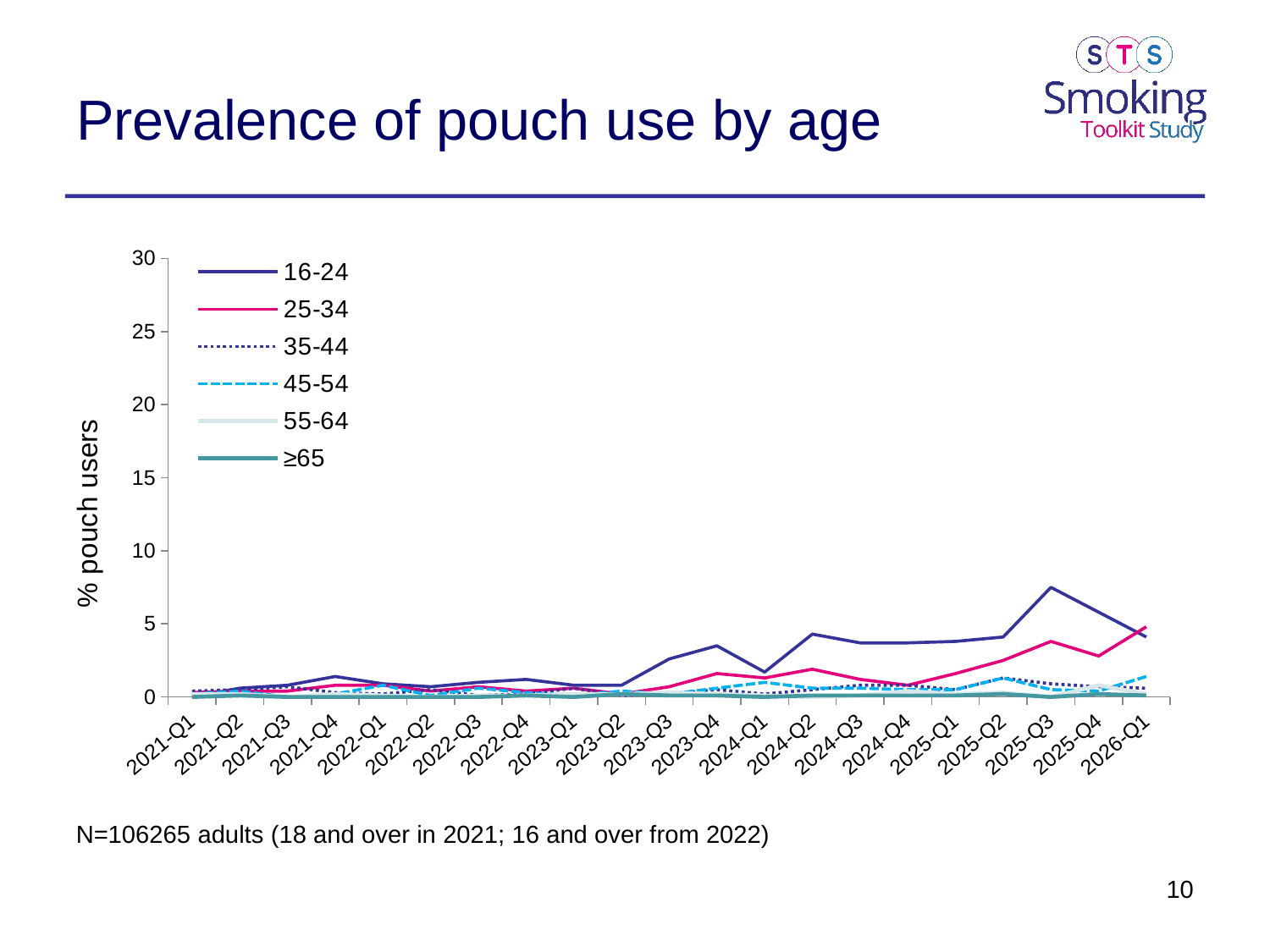
Is the value for the 16-24 series at 2025-Q3 greater or less than 10? less Is the value for the ≥65 series at 2026-Q1 greater or less than 5? less What is the label on the y axis? % pouch users Is the value for the 25-34 series at 2025-Q3 greater or less than 5? less What kind of chart is shown on the slide? line chart At 2025-Q3, which is larger: the value for 16-24 or the value for 25-34? 16-24 Does the 16-24 series generally rise or fall from 2021-Q1 to 2025-Q3? rise How many quarters are shown along the x axis? 21 What is the first quarter shown on the x axis? 2021-Q1 Which age group has the highest value at 2025-Q3? 16-24 How many series does the legend list? 6